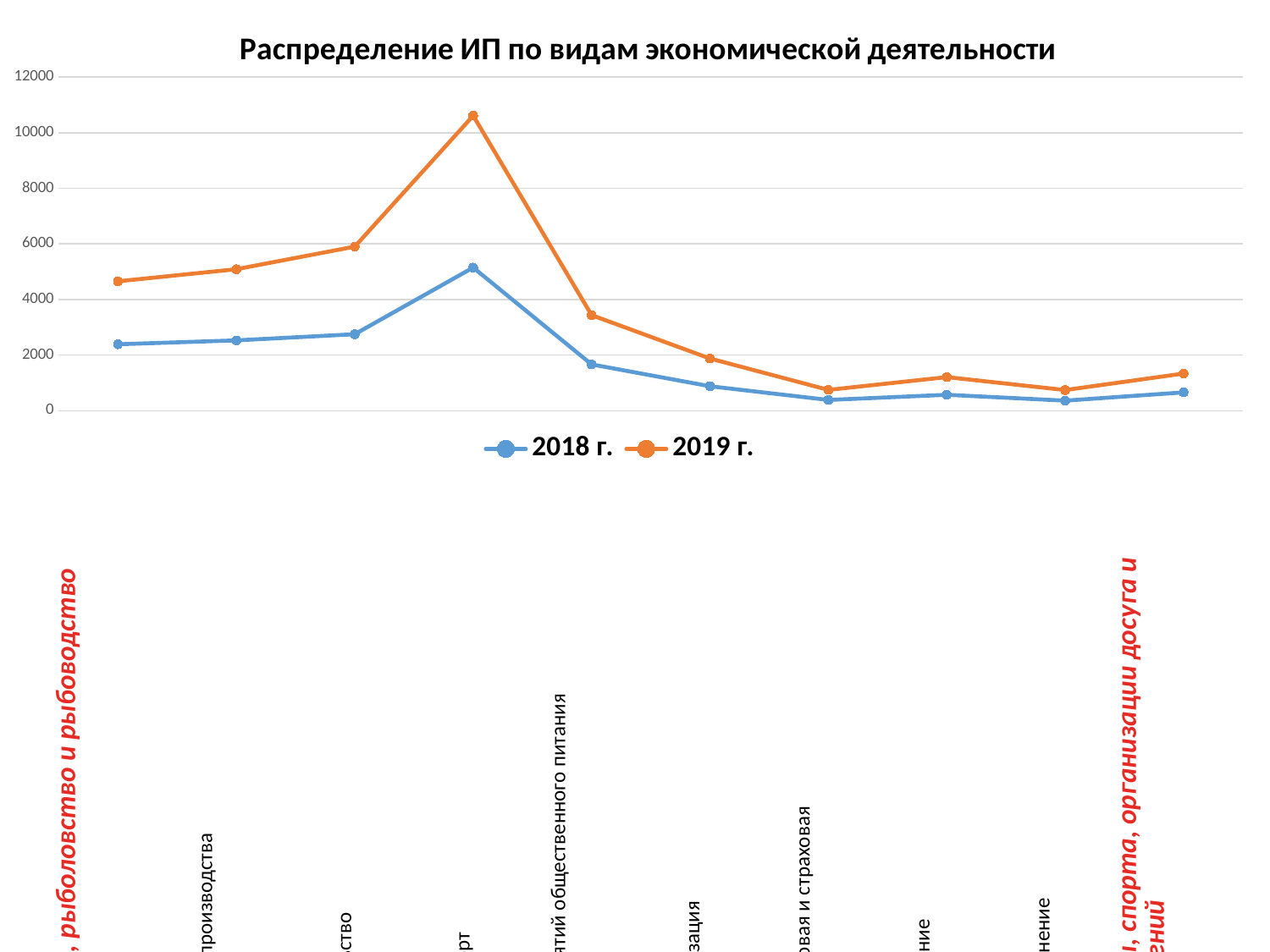
Is the highest value of the 2018 г. series greater or less than 6000? less Do the values of the 2019 г. series rise or fall from the fourth point to the seventh point along the x axis? fall At the fourth category (the peak), which series has the larger value, 2018 г. or 2019 г.? 2019 г. What is the title of the chart? Распределение ИП по видам экономической деятельности What are the two series named in the legend? 2018 г. and 2019 г. What kind of chart is shown on the slide? line chart How many series does the legend list? 2 Is the first (leftmost) value of the 2019 г. series greater or less than 4000? greater How many data points does each series have? 10 Which series reaches the highest value on the chart, 2018 г. or 2019 г.? 2019 г. Is the first (leftmost) value of the 2018 г. series greater or less than 4000? less